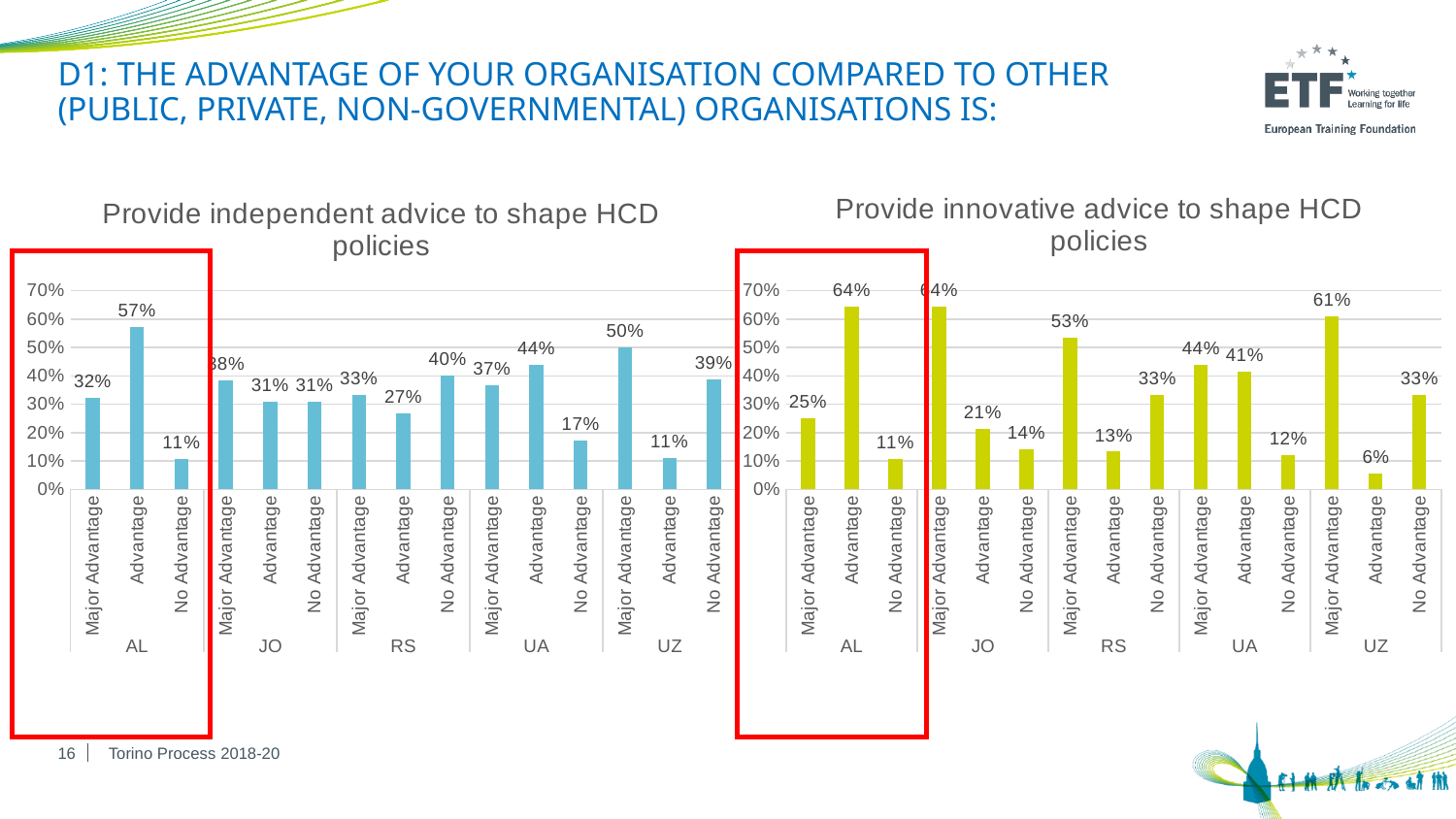
How many countries are shown on the x axis of the 'Provide independent advice to shape HCD policies' chart? 5 In the 'Provide independent advice to shape HCD policies' chart, what is the value for Major Advantage in UZ? 50% What type of chart is the 'Provide innovative advice to shape HCD policies' chart? Bar chart In the 'Provide innovative advice to shape HCD policies' chart, which bar has the lowest value? Advantage in UZ In the 'Provide innovative advice to shape HCD policies' chart, what is the difference between Advantage in AL and Major Advantage in AL? 39% In the 'Provide independent advice to shape HCD policies' chart, what is the difference between Advantage and No Advantage in UA? 27% In the 'Provide innovative advice to shape HCD policies' chart, what is the value for Advantage in UZ? 6% In the 'Provide independent advice to shape HCD policies' chart, which bar has the highest value? Advantage in AL In the 'Provide innovative advice to shape HCD policies' chart, what is the value for Major Advantage in RS? 53% In the 'Provide independent advice to shape HCD policies' chart, what is the value for No Advantage in RS? 40% In the 'Provide innovative advice to shape HCD policies' chart, which is larger: Major Advantage in UA or Advantage in UA? Major Advantage in UA In the 'Provide independent advice to shape HCD policies' chart, what is the value for Advantage in AL? 57%